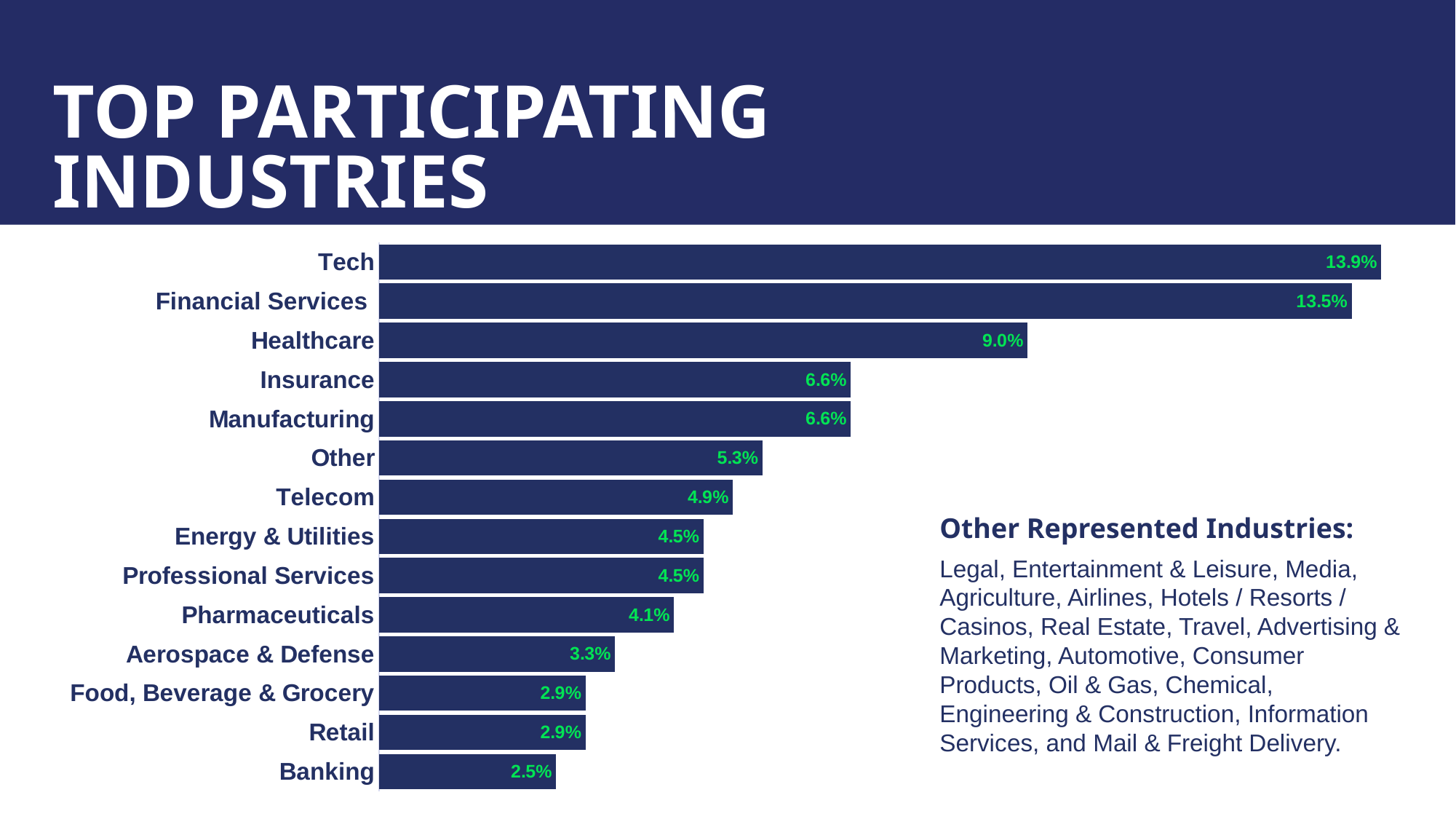
What is the value for Pharmaceuticals? 4.1% How many industries are shown in the chart? 14 Which industry has the lowest value? Banking What kind of chart is shown on the slide? Bar chart What is the title of the slide? TOP PARTICIPATING INDUSTRIES Which is larger, the value for Telecom or the value for Other? Other What is the difference between the values for Healthcare and Insurance? 2.4% What is the difference between the values for Tech and Financial Services? 0.4% What is the value for Healthcare? 9.0% What is the value for Aerospace & Defense? 3.3% Which industry has the highest value? Tech What is the value for Tech? 13.9%